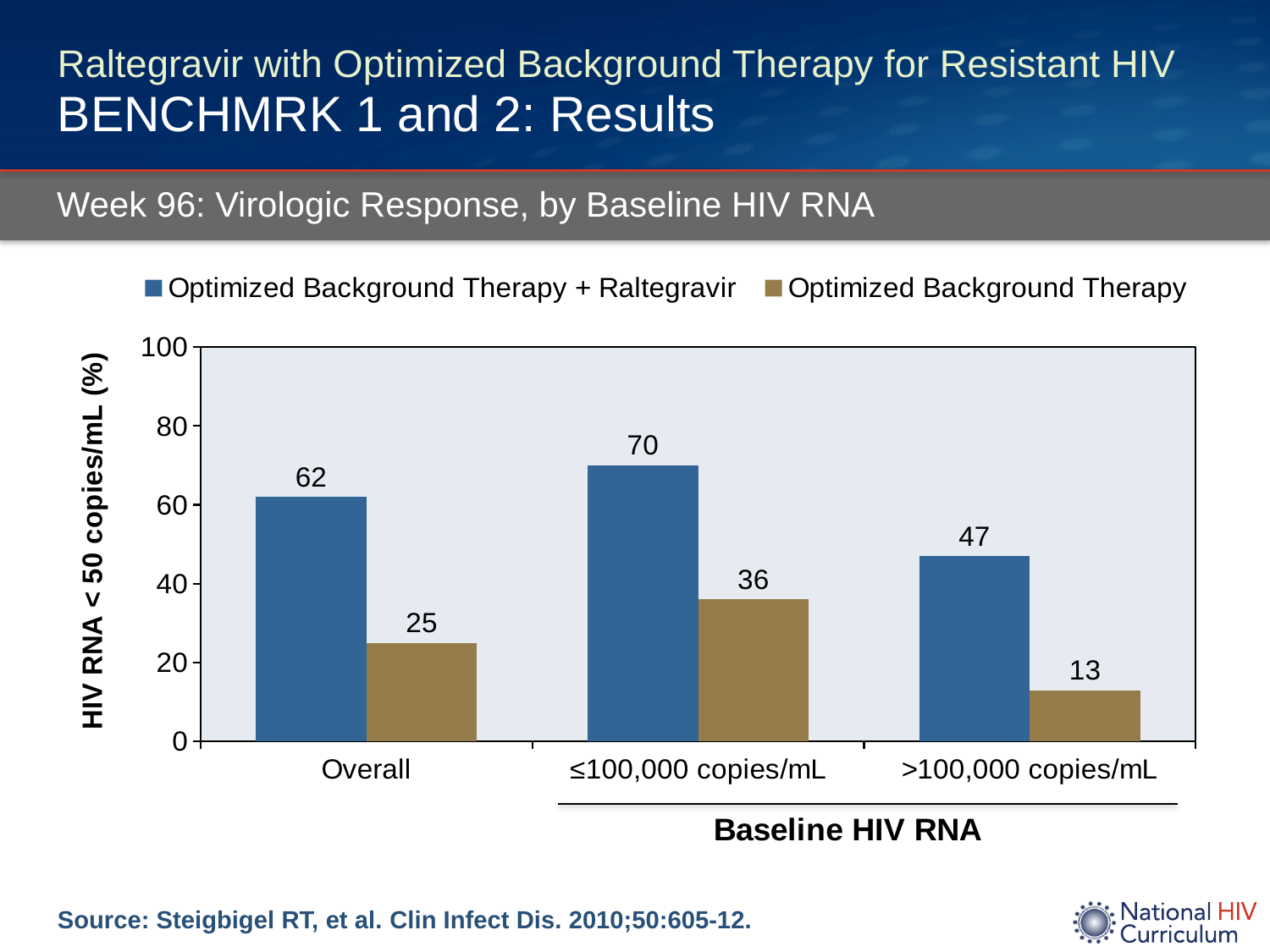
Which is larger: the Optimized Background Therapy value for ≤100,000 copies/mL or the Optimized Background Therapy value for Overall? ≤100,000 copies/mL What is the difference between the two series in the >100,000 copies/mL category? 34 What is the label of the y axis? HIV RNA < 50 copies/mL (%) What is the value for Optimized Background Therapy in the ≤100,000 copies/mL category? 36 What is the value for Optimized Background Therapy in the >100,000 copies/mL category? 13 How many series does the legend list? 2 What kind of chart is shown on the slide? Bar chart How many categories are shown on the x axis? 3 Which category has the lowest value for Optimized Background Therapy? >100,000 copies/mL What is the difference between the Optimized Background Therapy + Raltegravir values for ≤100,000 copies/mL and >100,000 copies/mL? 23 Which category has the highest value for Optimized Background Therapy + Raltegravir? ≤100,000 copies/mL What is the value for Optimized Background Therapy + Raltegravir in the Overall category? 62